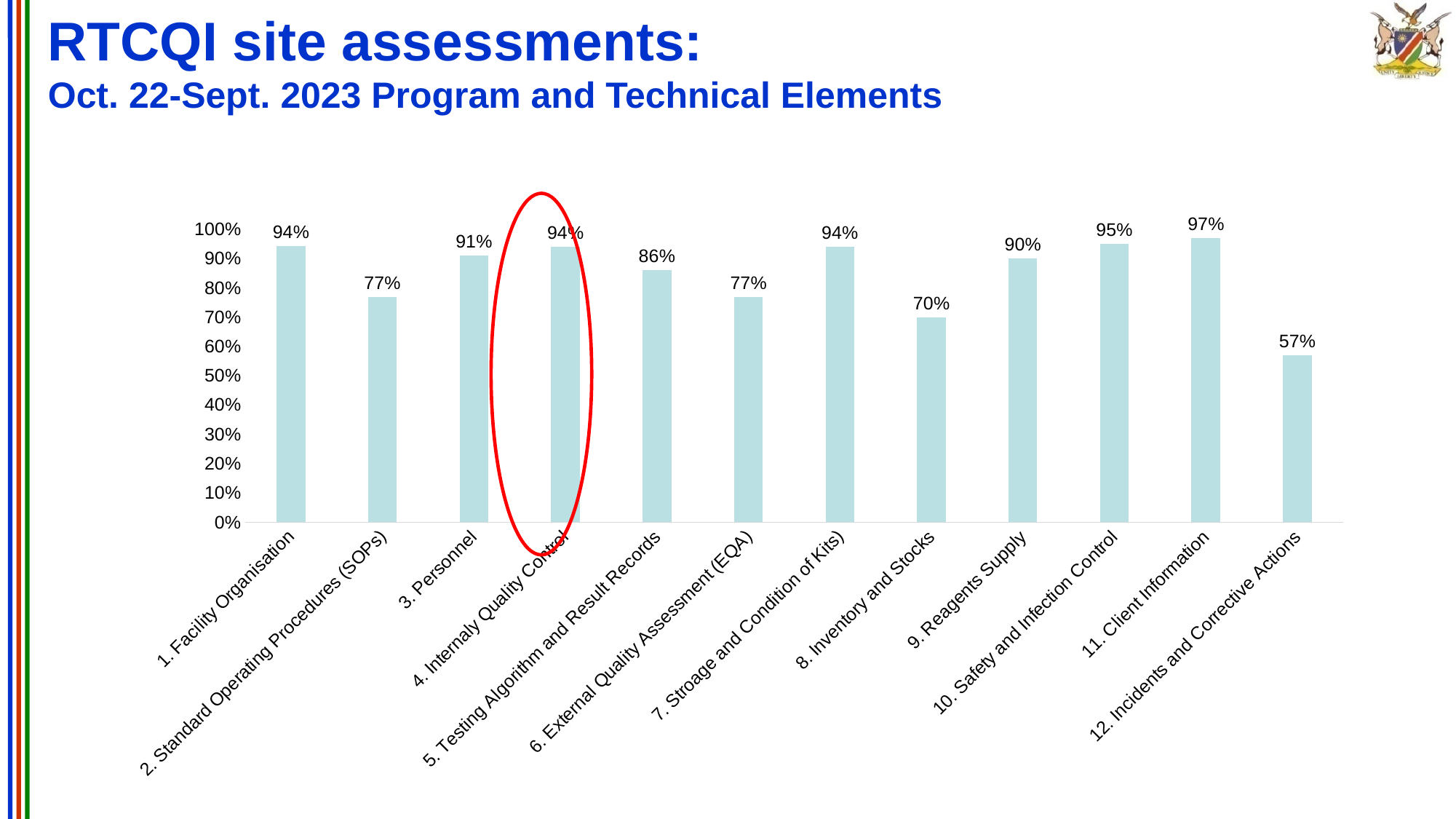
Which category has the lowest value? 12. Incidents and Corrective Actions What kind of chart is shown on the slide? Bar chart What is the value for 11. Client Information? 97% Which category has the highest value? 11. Client Information What is the value for 5. Testing Algorithm and Result Records? 86% Which is larger, the value for 9. Reagents Supply or the value for 8. Inventory and Stocks? 9. Reagents Supply Which category is circled in red on the chart? 4. Internaly Quality Control What is the value for 8. Inventory and Stocks? 70% What is the value for 12. Incidents and Corrective Actions? 57% What is the difference between the values for 11. Client Information and 12. Incidents and Corrective Actions? 40% What is the value for 10. Safety and Infection Control? 95% How many categories are shown on the chart? 12